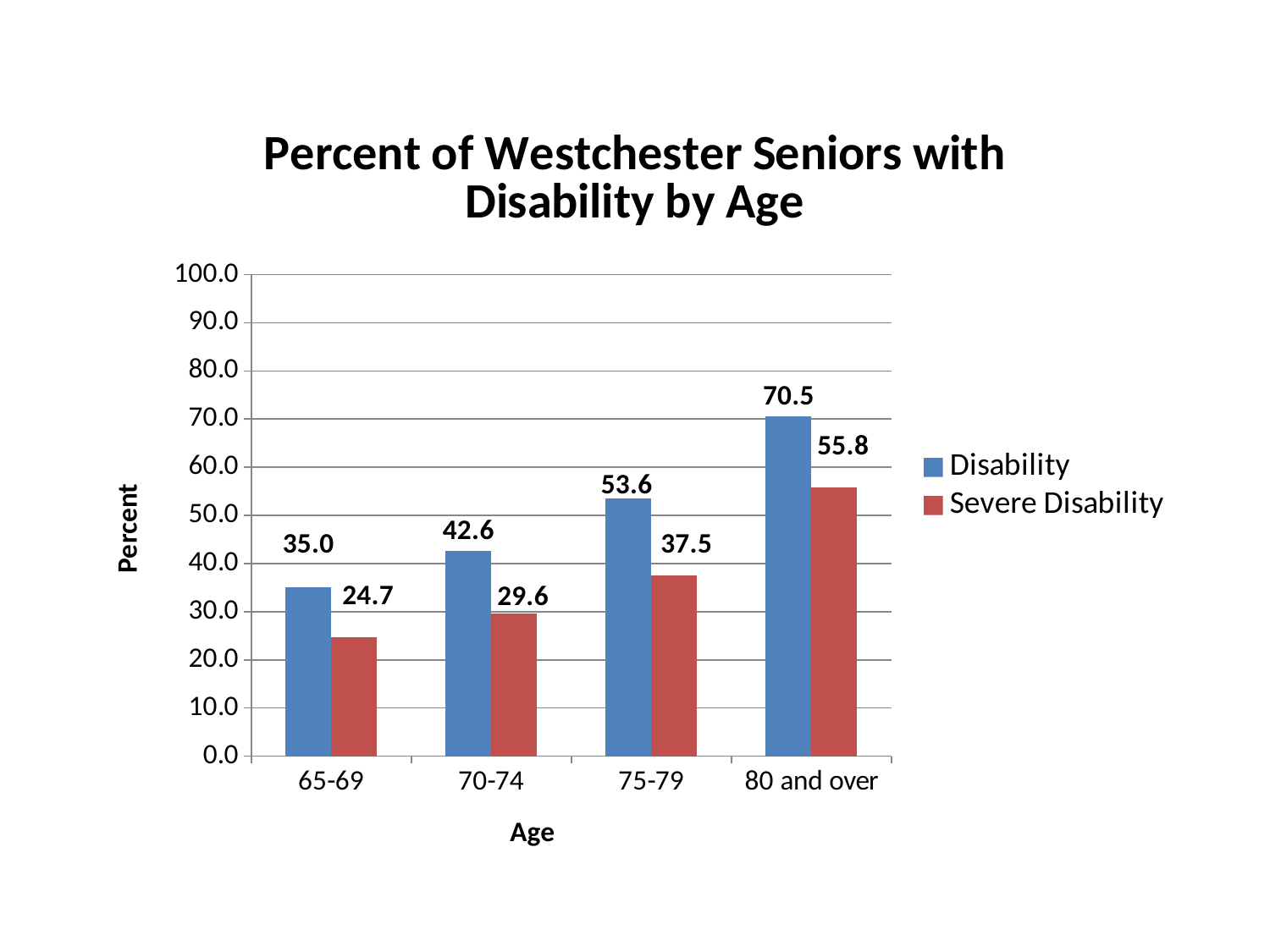
Do the Disability values rise or fall as age increases along the x axis? Rise How many series does the legend list? 2 Which age group has the highest Severe Disability value? 80 and over What is the Disability value for the 65-69 age group? 35.0 What kind of chart is shown on the slide? Bar chart Is the Disability value for the 75-79 age group greater or less than 50.0? greater What is the Severe Disability value for the 75-79 age group? 37.5 Which is larger: the Severe Disability value for 80 and over or the Disability value for 75-79? Severe Disability for 80 and over What is the Disability value for the 80 and over age group? 70.5 How many age groups are shown on the x axis? 4 Which age group has the lowest Disability value? 65-69 What is the difference between the Disability and Severe Disability values for the 70-74 age group? 13.0